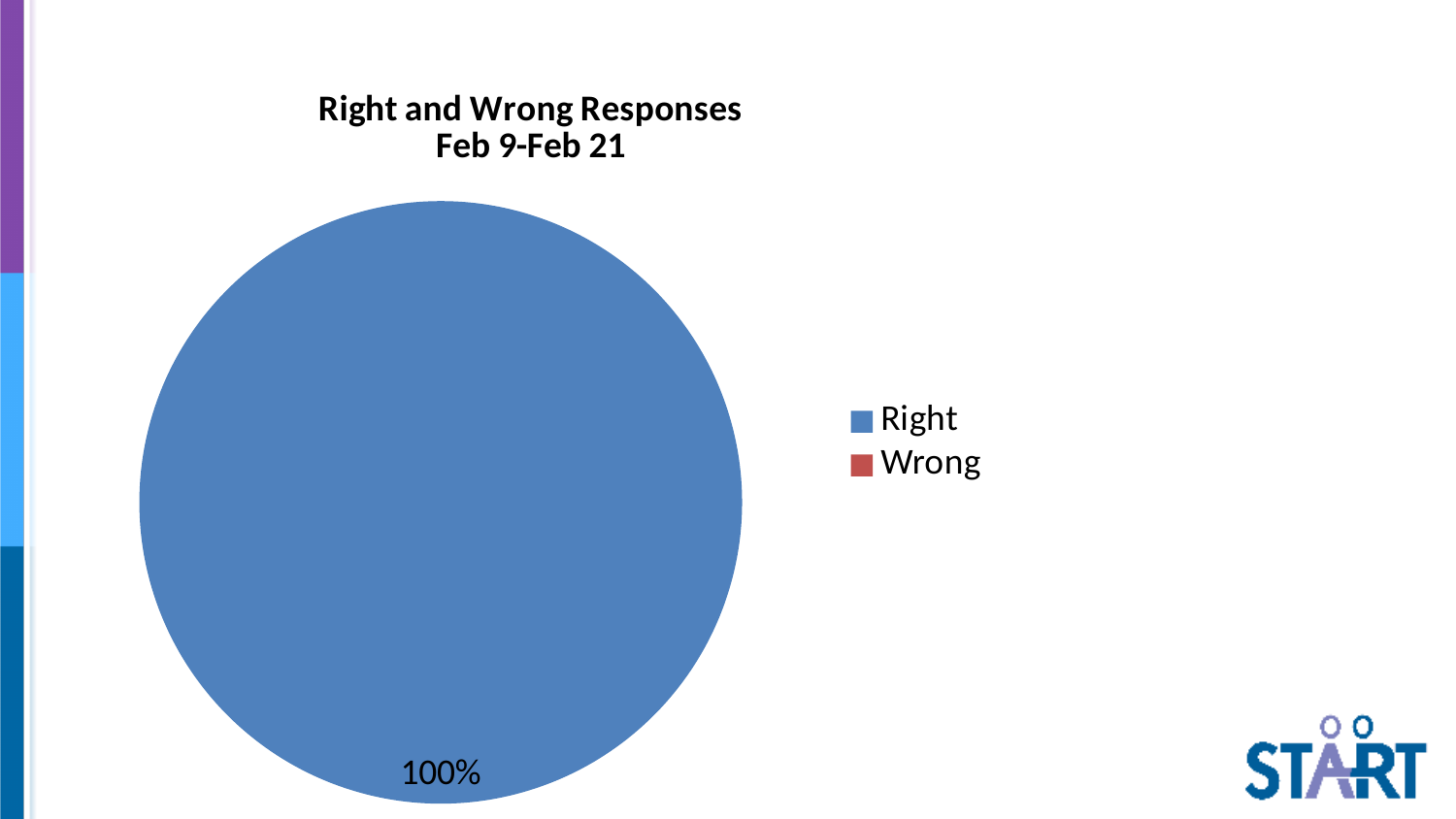
Which category has the largest share of the pie? Right How many entries does the legend list? 2 What share of the pie does the Right slice take? 100% What date range does the chart title cover? Feb 9-Feb 21 What colour is the Right slice in the legend? blue Which is larger, the share for Right or the share for Wrong? Right What kind of chart is shown on the slide? pie chart Which category has the smallest share of the pie? Wrong What is the title of the chart? Right and Wrong Responses Feb 9-Feb 21